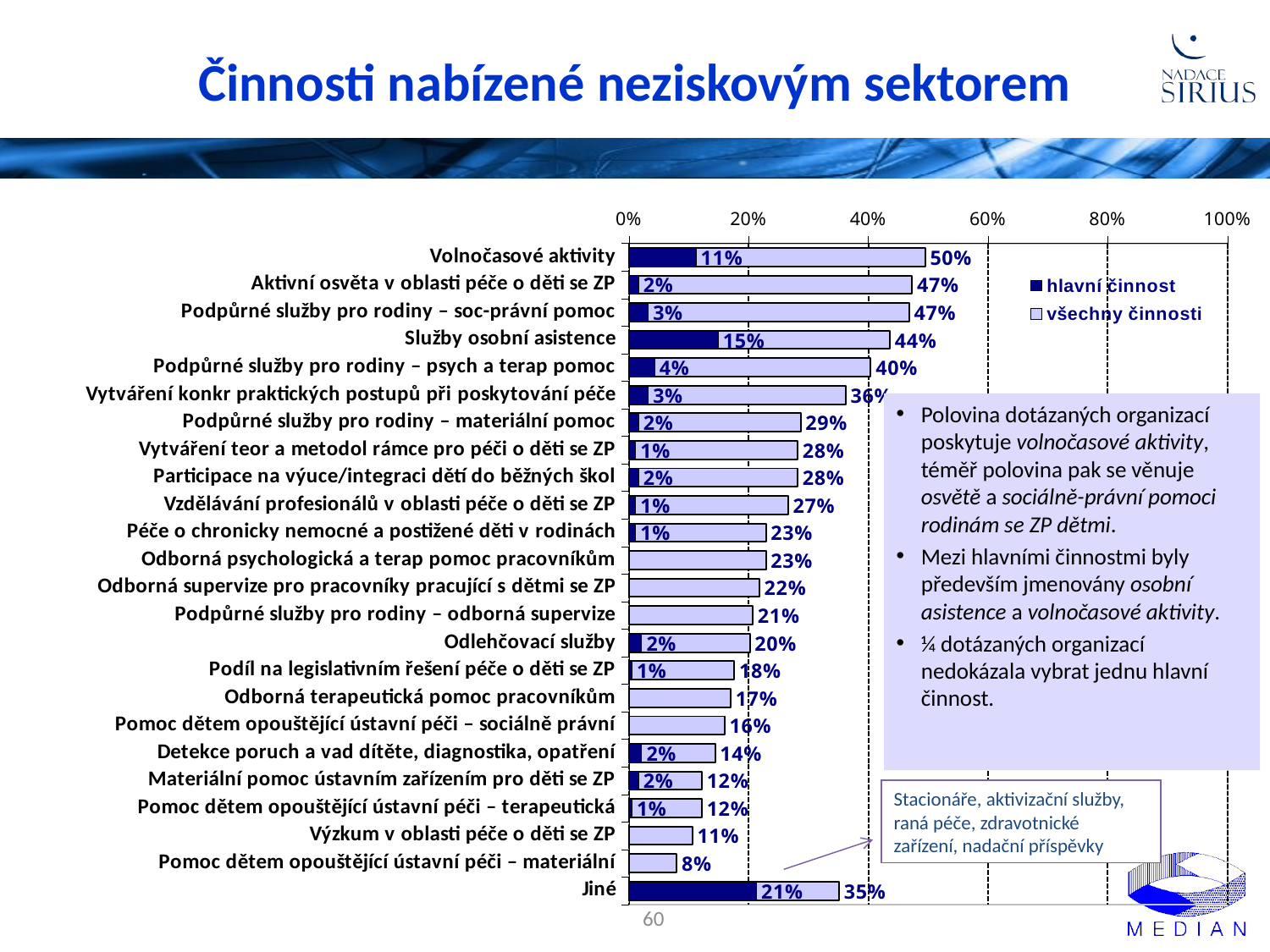
What is the 'hlavní činnost' value for Služby osobní asistence? 15% What is the 'všechny činnosti' value for Volnočasové aktivity? 50% What is the difference between the 'všechny činnosti' values for Volnočasové aktivity and Služby osobní asistence? 6% What are the two series names shown in the legend? hlavní činnost, všechny činnosti Which category has the highest 'všechny činnosti' value? Volnočasové aktivity How many series does the legend list? 2 Is the 'všechny činnosti' value for Jiné greater or less than 40%? less Which category has the highest 'hlavní činnost' value? Jiné What type of chart is shown on the slide? bar chart Which has a larger 'všechny činnosti' value: Výzkum v oblasti péče o děti se ZP or Detekce poruch a vad dítěte, diagnostika, opatření? Detekce poruch a vad dítěte, diagnostika, opatření Which category has the lowest 'všechny činnosti' value? Pomoc dětem opouštějící ústavní péči – materiální What is the 'všechny činnosti' value for Odlehčovací služby? 20%